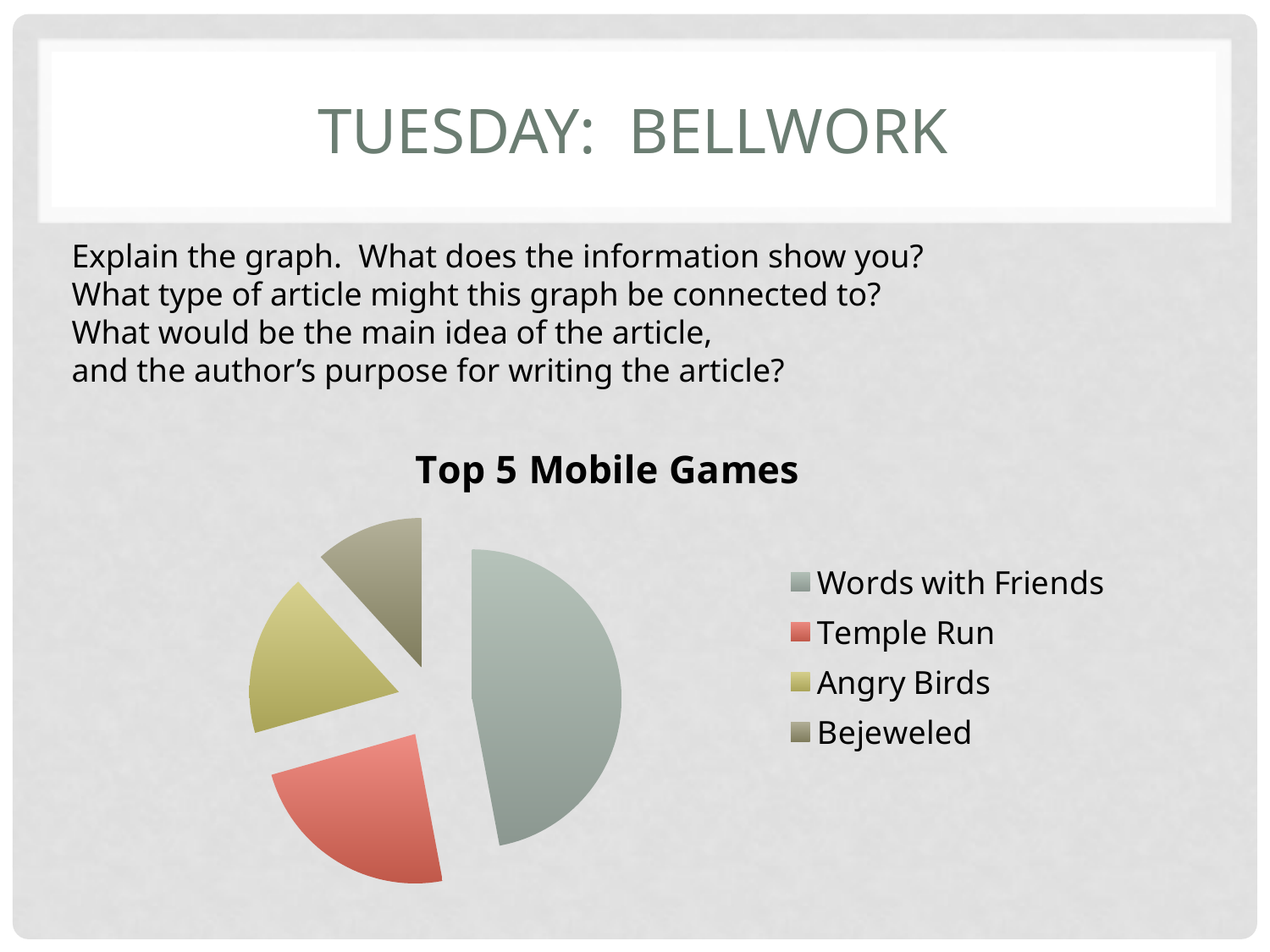
Which slice is larger, Temple Run or Bejeweled? Temple Run Which slice is larger, Words with Friends or Temple Run? Words with Friends Which slice is larger, Angry Birds or Bejeweled? Angry Birds Which game has the smallest slice of the pie? Bejeweled What kind of chart is shown on the slide? pie chart Which game has the largest slice of the pie? Words with Friends How many slices does the pie chart have? 4 What is the title of the chart? Top 5 Mobile Games How many entries does the legend list? 4 What colour is the Temple Run slice? red